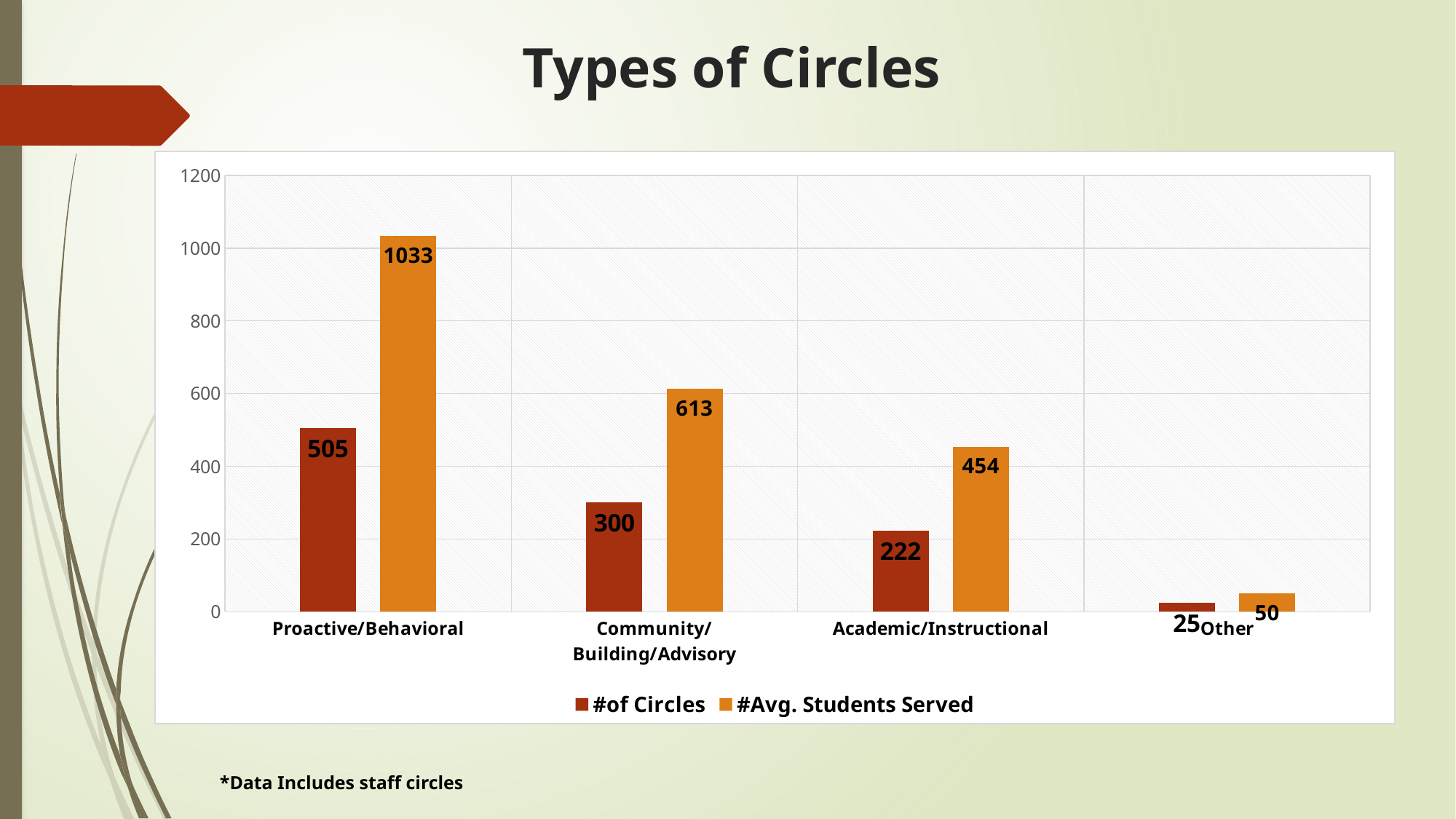
What is the difference between # Avg. Students Served and # of Circles for Proactive/Behavioral? 528 What is the # Avg. Students Served for Community/Building/Advisory? 613 How many series does the legend list? 2 How many categories are shown on the x axis? 4 Which category has the lowest # of Circles? Other What is the # Avg. Students Served for Academic/Instructional? 454 Which is larger: # of Circles for Community/Building/Advisory or # of Circles for Academic/Instructional? Community/Building/Advisory What kind of chart is shown on the slide? Bar chart What is the title of the slide? Types of Circles What is the # of Circles for Proactive/Behavioral? 505 What is the # of Circles for Other? 25 Which category has the highest # Avg. Students Served? Proactive/Behavioral